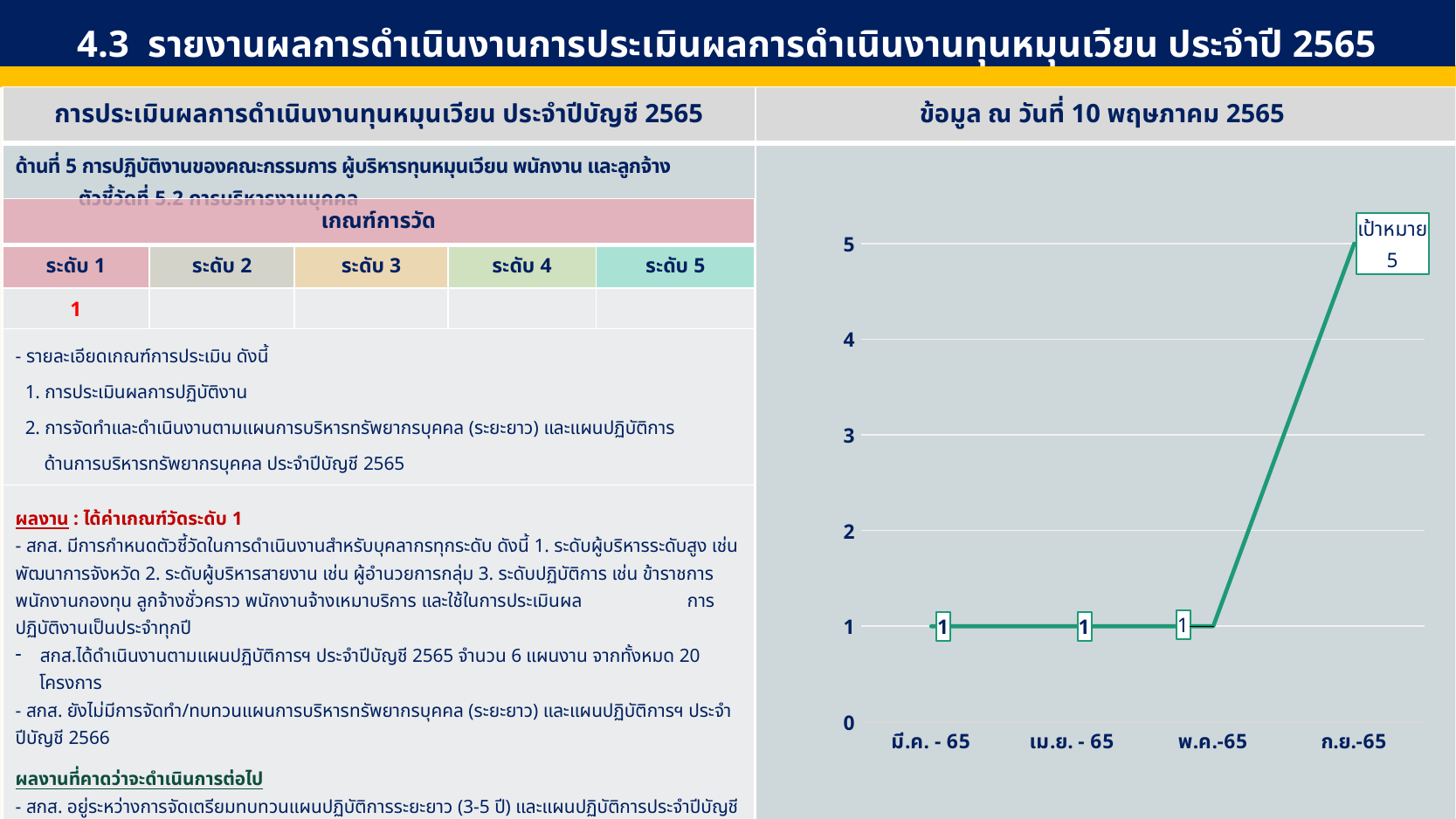
What label is attached to the data point for ก.ย.-65? เป้าหมาย 5 Is the value for ก.ย.-65 greater or less than 4? greater What is the value plotted for พ.ค.-65? 1 What is the value plotted for ก.ย.-65? 5 What is the value plotted for มี.ค. - 65? 1 What is the value plotted for เม.ย. - 65? 1 Does the line rise or fall between พ.ค.-65 and ก.ย.-65? rise What is the difference between the value for ก.ย.-65 and the value for พ.ค.-65? 4 Which is larger, the value for ก.ย.-65 or the value for มี.ค. - 65? ก.ย.-65 What kind of chart is shown on the right side of the slide? line chart How many categories are shown on the x axis of the line chart? 4 Which category has the highest value on the line chart? ก.ย.-65